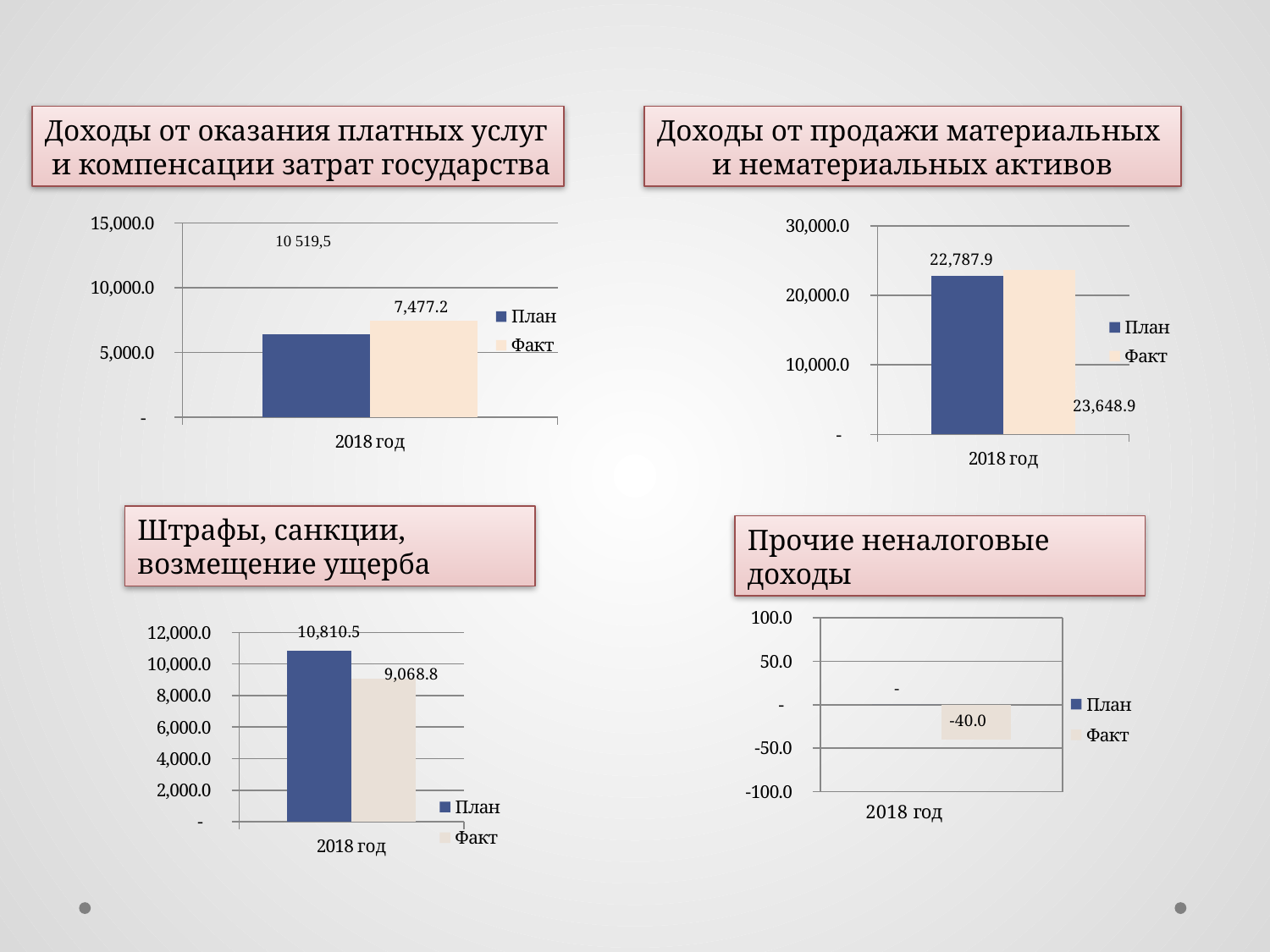
In the chart titled "Штрафы, санкции, возмещение ущерба", what is the value for План? 10,810.5 In the chart titled "Доходы от продажи материальных и нематериальных активов", what is the value for Факт? 23,648.9 In the chart titled "Прочие неналоговые доходы", what is the value for Факт? -40.0 In the chart titled "Штрафы, санкции, возмещение ущерба", which is larger, План or Факт? План In the chart titled "Доходы от оказания платных услуг и компенсации затрат государства", is the value for План greater or less than 5,000.0? greater In the chart titled "Доходы от продажи материальных и нематериальных активов", what is the difference between Факт and План? 861.0 In the chart titled "Доходы от продажи материальных и нематериальных активов", what is the value for План? 22,787.9 In the chart titled "Доходы от оказания платных услуг и компенсации затрат государства", what is the value for Факт? 7,477.2 In the chart titled "Доходы от продажи материальных и нематериальных активов", which is larger, План or Факт? Факт How many series does the legend list in the chart titled "Штрафы, санкции, возмещение ущерба"? 2 In the chart titled "Штрафы, санкции, возмещение ущерба", what is the value for Факт? 9,068.8 In the chart titled "Штрафы, санкции, возмещение ущерба", what is the difference between План and Факт? 1,741.7